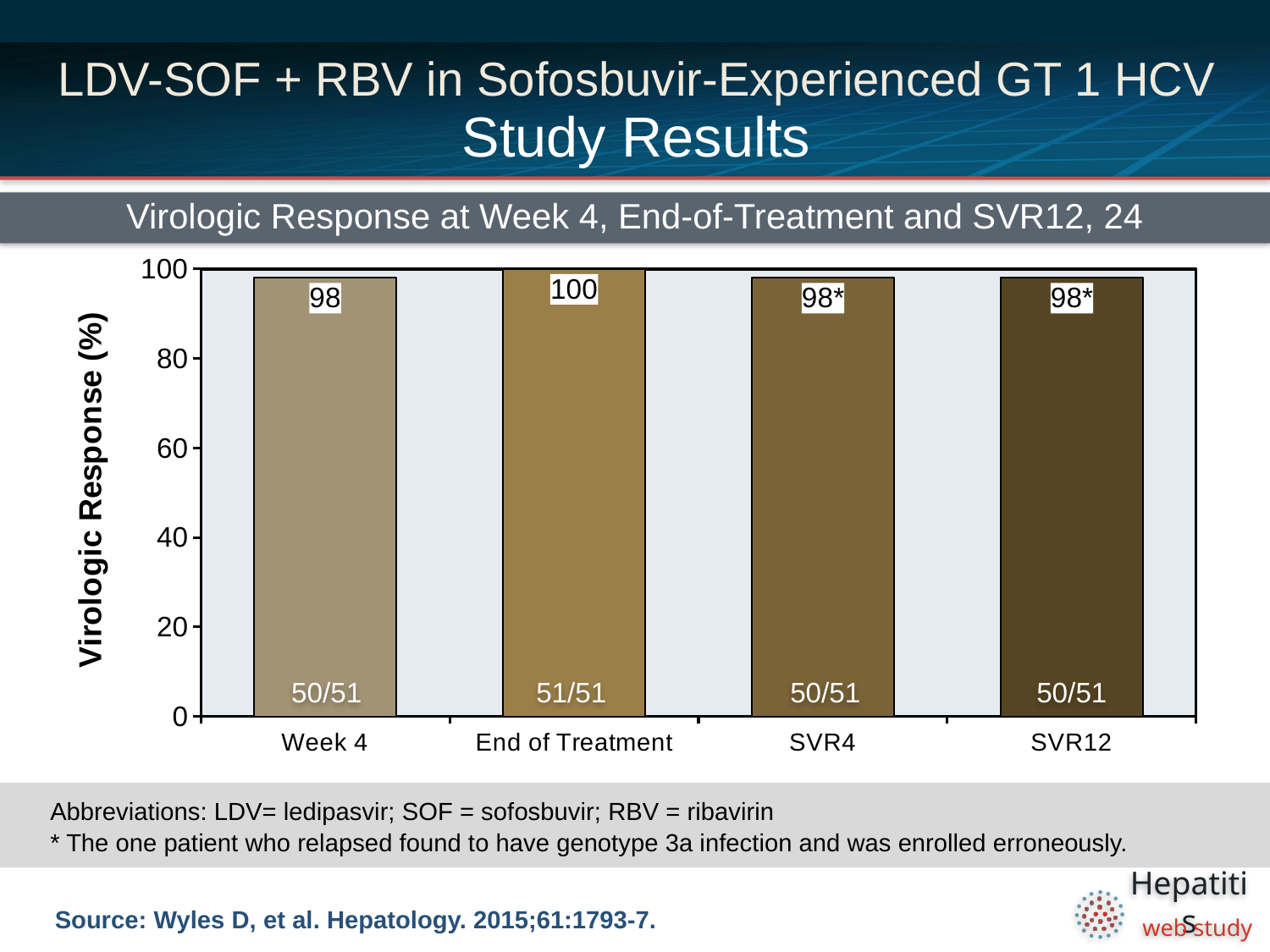
Which is larger, the virologic response at End of Treatment or at Week 4? End of Treatment What fraction of patients is shown inside the SVR4 bar? 50/51 What is the difference in virologic response (%) between End of Treatment and SVR12? 2 Is the virologic response at SVR4 greater or less than 80? greater What fraction of patients is shown inside the End of Treatment bar? 51/51 Which time point has the highest virologic response? End of Treatment What is the virologic response (%) at Week 4? 98 What is the label of the y axis? Virologic Response (%) What kind of chart is shown on the slide? Bar chart How many time points (categories) are shown on the x axis? 4 What is the virologic response (%) at SVR12? 98* What is the virologic response (%) at End of Treatment? 100